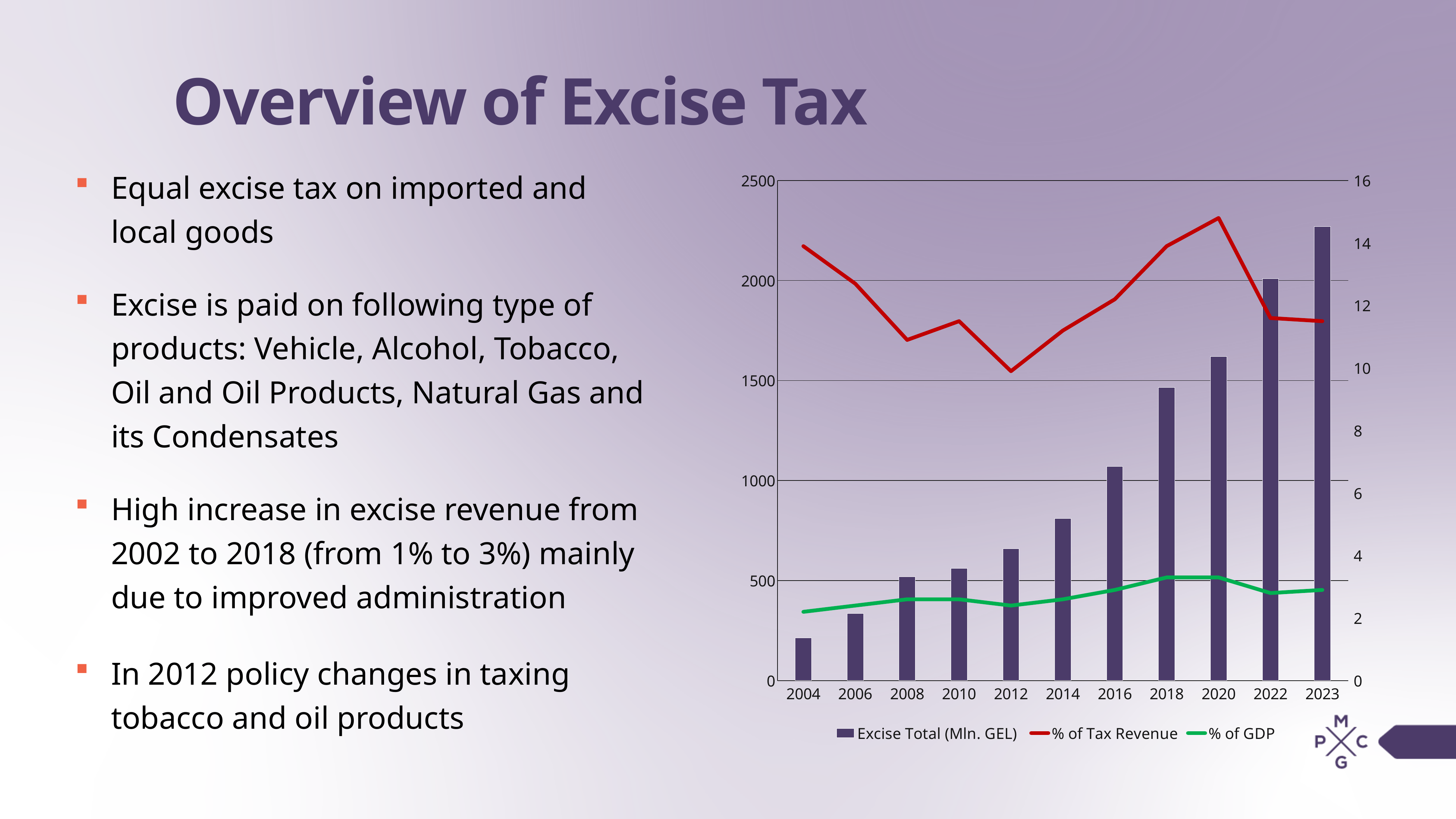
In which year does the % of Tax Revenue line reach its highest point? 2020 Is the Excise Total (Mln. GEL) for 2016 greater or less than 1000? greater Which is larger, the Excise Total (Mln. GEL) bar for 2020 or for 2016? 2020 Is the Excise Total (Mln. GEL) for 2023 greater or less than 2000? greater How many years are shown on the x axis of the chart? 11 Is the Excise Total (Mln. GEL) for 2004 greater or less than 500? less How many series does the chart's legend list? 3 Which year has the lowest Excise Total (Mln. GEL) bar? 2004 What kind of chart is shown on the slide? A combined bar and line chart Which year has the highest Excise Total (Mln. GEL) bar? 2023 In which year does the % of Tax Revenue line reach its lowest point? 2012 Do the Excise Total (Mln. GEL) bars generally rise or fall from 2004 to 2023? rise